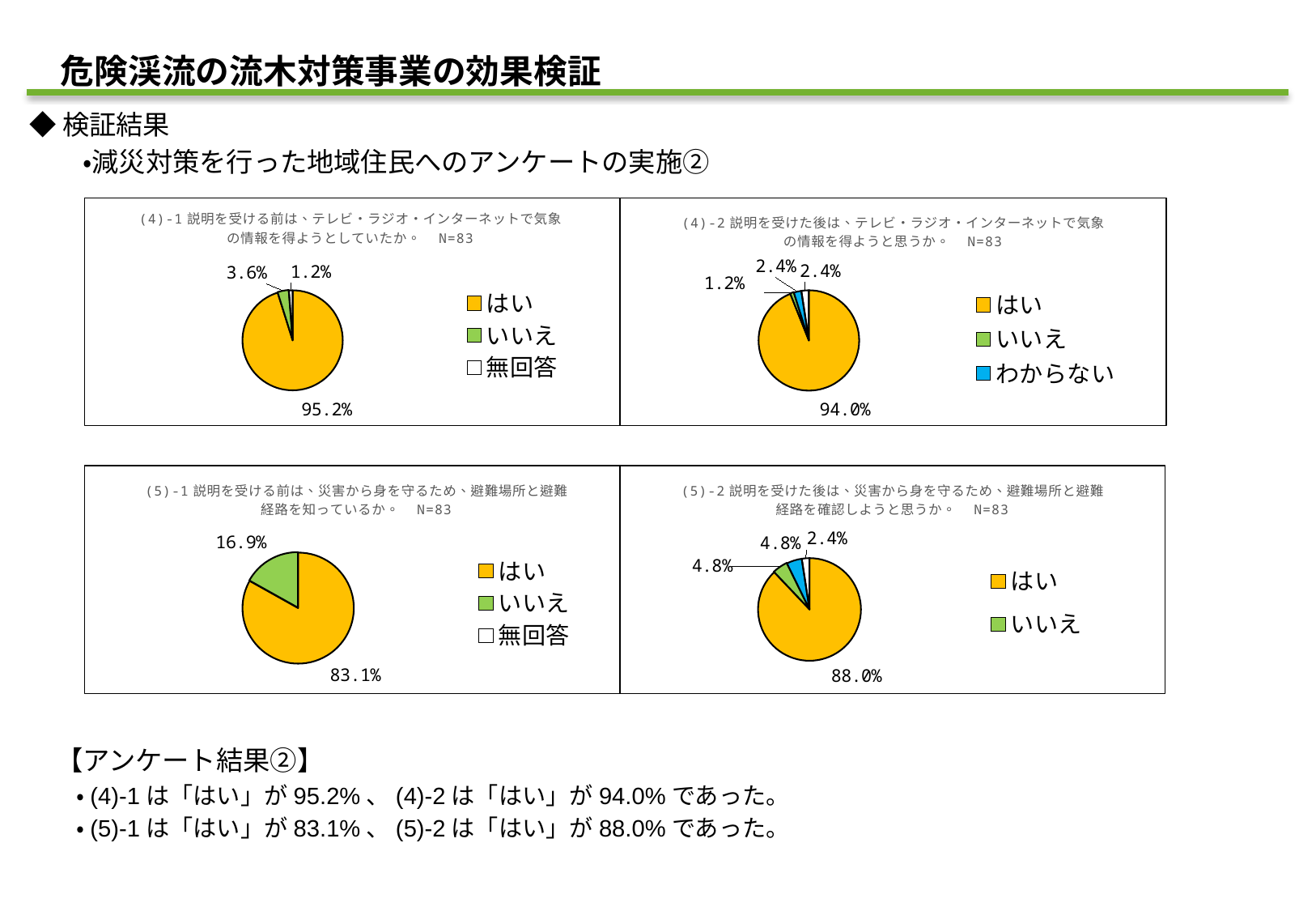
In the (5)-1 chart (bottom-left), what is the difference between the はい and いいえ shares? 66.2% In the (5)-1 chart (bottom-left), what percentage answered いいえ? 16.9% In the (5)-1 chart (bottom-left), what percentage answered はい? 83.1% How many entries does the legend of the (4)-2 chart (top-right) list? 3 In the (4)-1 chart (top-left), what percentage is 無回答? 1.2% In the (4)-1 chart (top-left), what percentage answered いいえ? 3.6% In the (4)-2 chart (top-right), what percentage answered はい? 94.0% In the (5)-2 chart (bottom-right), what percentage answered はい? 88.0% In the (4)-1 chart (top-left), what percentage answered はい? 95.2% Which chart has the larger はい share, (5)-1 or (5)-2? (5)-2 Which chart has the larger はい share, (4)-1 or (4)-2? (4)-1 What type of chart is used for the (4)-1 survey result? Pie chart